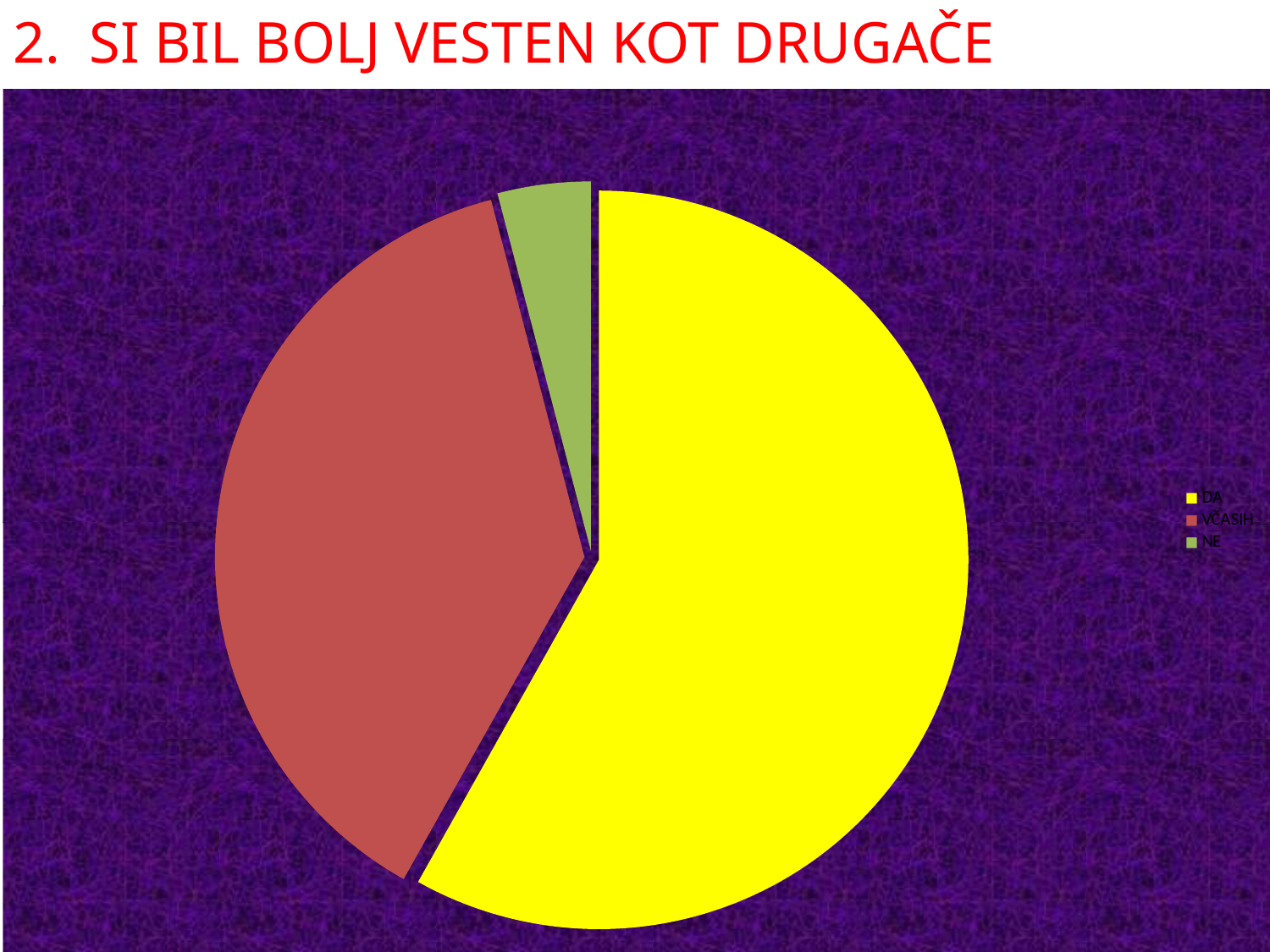
Which category has the smallest slice of the pie? NE What is the title of the slide containing the pie chart? 2. SI BIL BOLJ VESTEN KOT DRUGAČE How many slices does the pie chart have? 3 How many entries does the legend list? 3 Which category has the largest slice of the pie? DA What kind of chart is shown on the slide? pie chart Which slice is larger, DA or VČASIH? DA Which colour represents the DA category in the pie chart? yellow Which slice is larger, VČASIH or NE? VČASIH